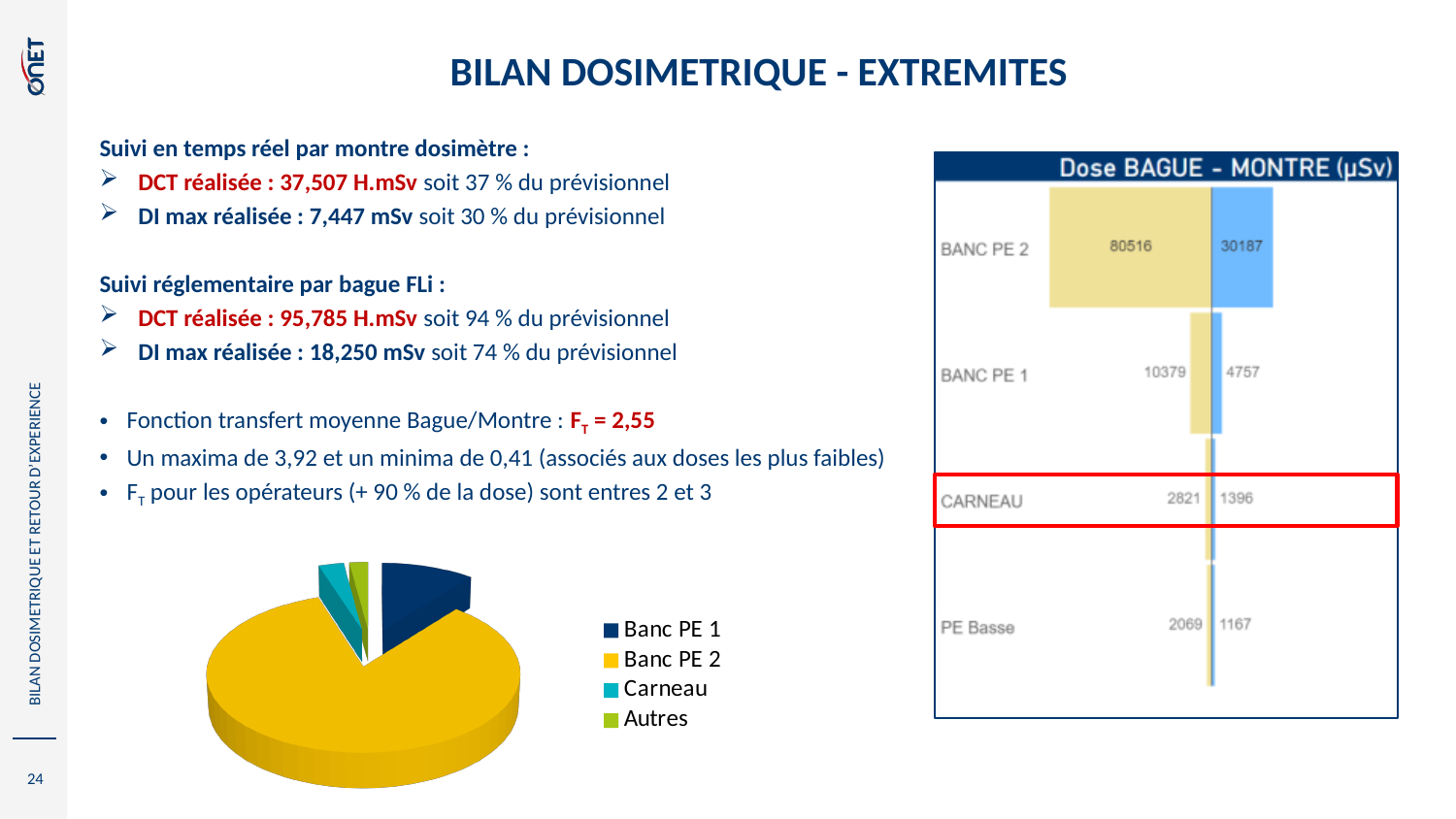
What kind of chart is shown at the bottom left of the slide? Pie chart In the 'Dose BAGUE - MONTRE (µSv)' chart, what is the BAGUE value for CARNEAU? 2821 In the 'Dose BAGUE - MONTRE (µSv)' chart, what is the BAGUE value for BANC PE 2? 80516 In the 'Dose BAGUE - MONTRE (µSv)' chart, what is the MONTRE value for PE Basse? 1167 How many categories are shown in the 'Dose BAGUE - MONTRE (µSv)' chart? 4 In the 'Dose BAGUE - MONTRE (µSv)' chart, what is the difference between the BAGUE and MONTRE values for CARNEAU? 1425 What kind of chart is the 'Dose BAGUE - MONTRE (µSv)' chart? Bar chart In the 'Dose BAGUE - MONTRE (µSv)' chart, what is the MONTRE value for BANC PE 1? 4757 In the 'Dose BAGUE - MONTRE (µSv)' chart, which category has the lowest MONTRE value? PE Basse In the 'Dose BAGUE - MONTRE (µSv)' chart, which is larger for BANC PE 1: the BAGUE value or the MONTRE value? BAGUE In the 'Dose BAGUE - MONTRE (µSv)' chart, which category has the highest BAGUE value? BANC PE 2 How many entries does the legend of the pie chart at the bottom left list? 4